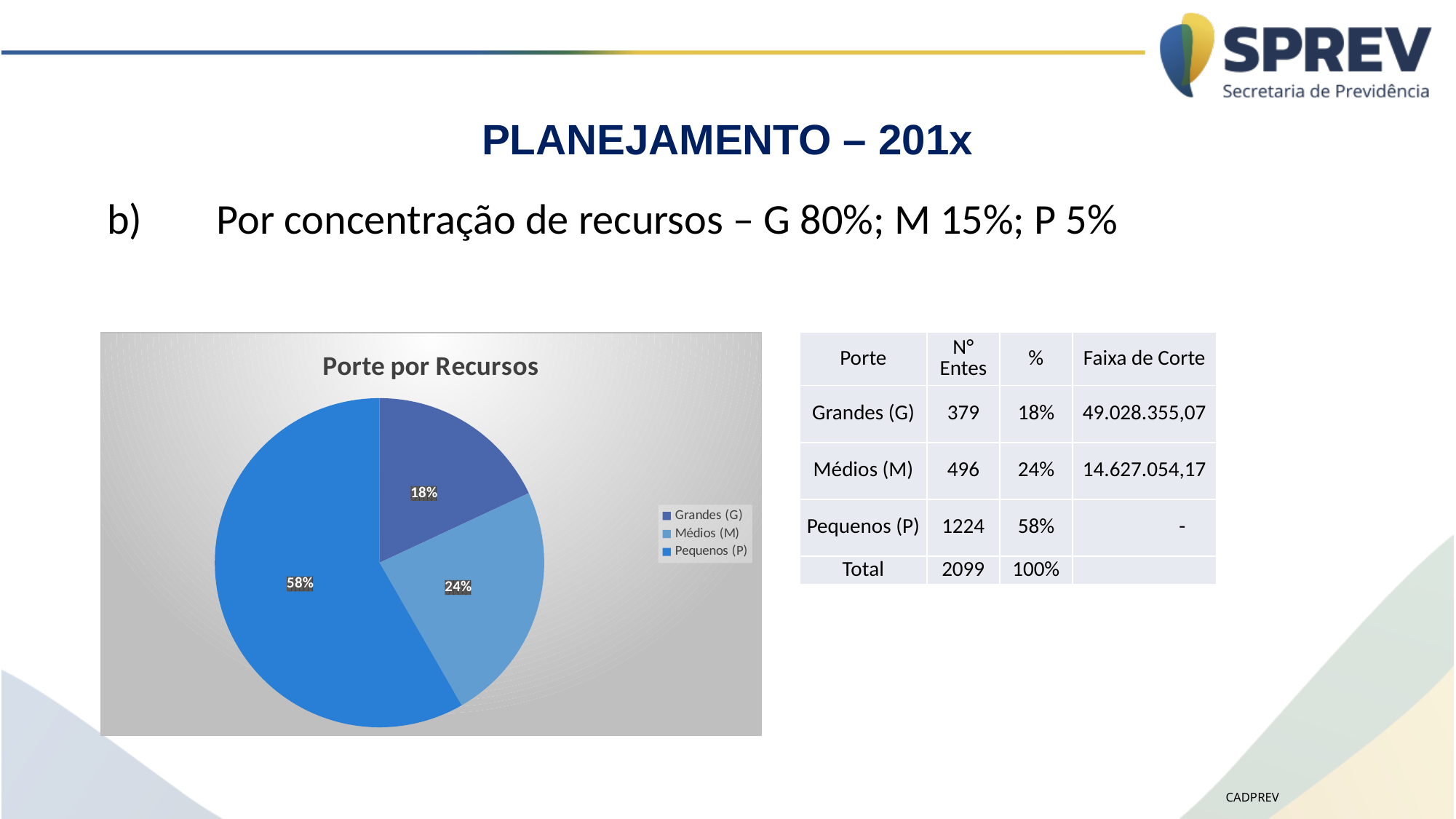
What is the title of the chart on the slide? Porte por Recursos What share of the pie does Grandes (G) have? 18% How many entries does the legend list? 3 Which category has the smallest slice of the pie? Grandes (G) How many slices does the pie chart have? 3 What share of the pie does Pequenos (P) have? 58% Which slice is larger, Médios (M) or Grandes (G)? Médios (M) What is the difference in percentage points between the Médios (M) slice and the Grandes (G) slice? 6 What share of the pie does Médios (M) have? 24% What kind of chart is "Porte por Recursos"? pie chart Which category has the largest slice of the pie? Pequenos (P) What is the difference in percentage points between the Pequenos (P) slice and the Médios (M) slice? 34